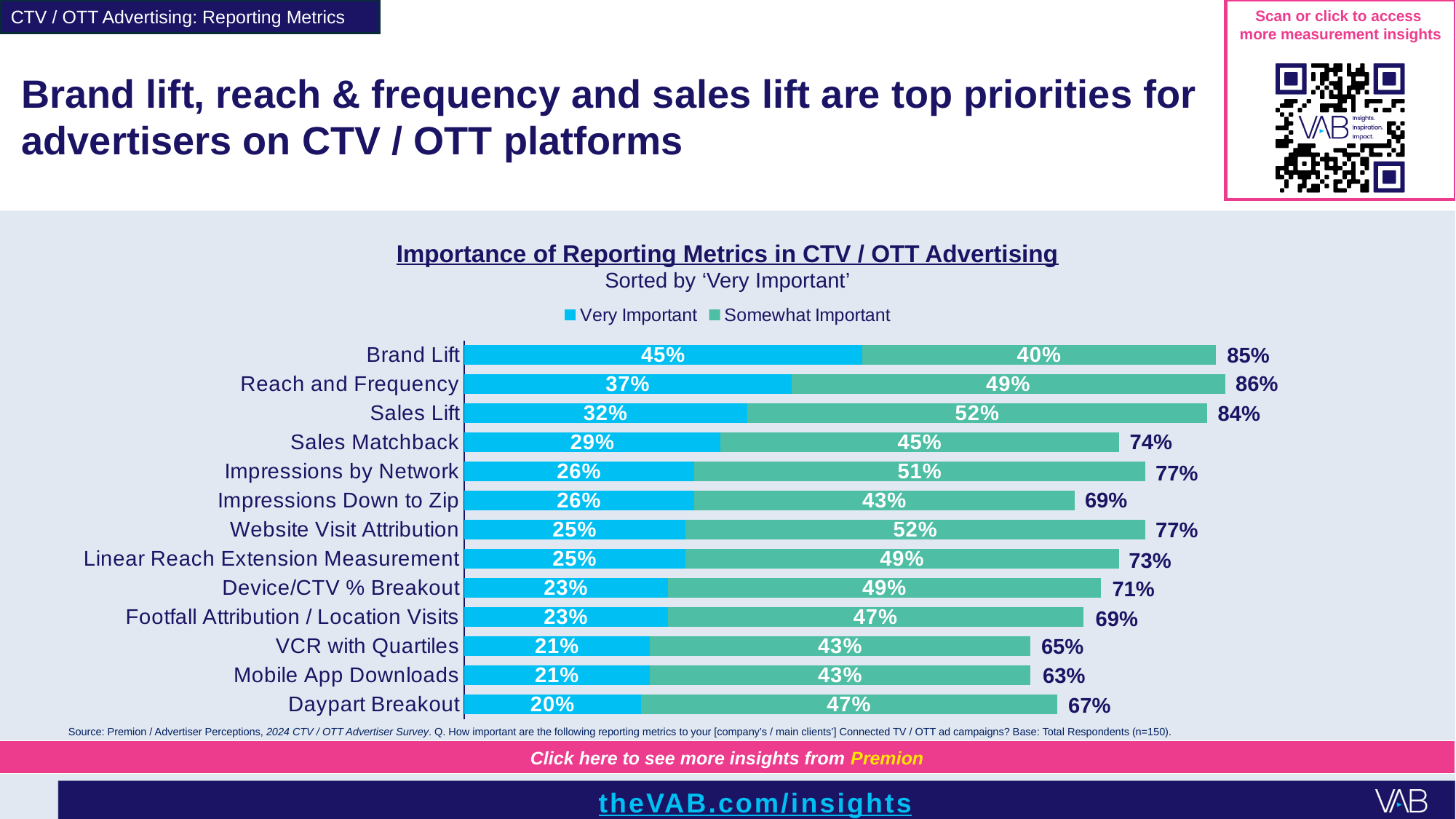
What is the subtitle under the chart title indicating how the bars are ordered? Sorted by 'Very Important' Which reporting metric has the highest combined total shown at the end of its bar? Reach and Frequency What type of chart is shown on the slide? Stacked horizontal bar chart Which has a larger 'Somewhat Important' value: Impressions by Network or Impressions Down to Zip? Impressions by Network What percentage of respondents rated Brand Lift as 'Very Important'? 45% How many reporting metrics (categories) are plotted in the chart? 13 Which reporting metric has the highest 'Very Important' percentage? Brand Lift What is the 'Somewhat Important' value for Sales Lift? 52% How many series does the chart legend list? 2 Which reporting metric has the lowest 'Very Important' percentage? Daypart Breakout What is the difference in percentage points between the 'Very Important' values for Brand Lift and Reach and Frequency? 8 percentage points What combined total is shown at the end of the Brand Lift bar? 85%